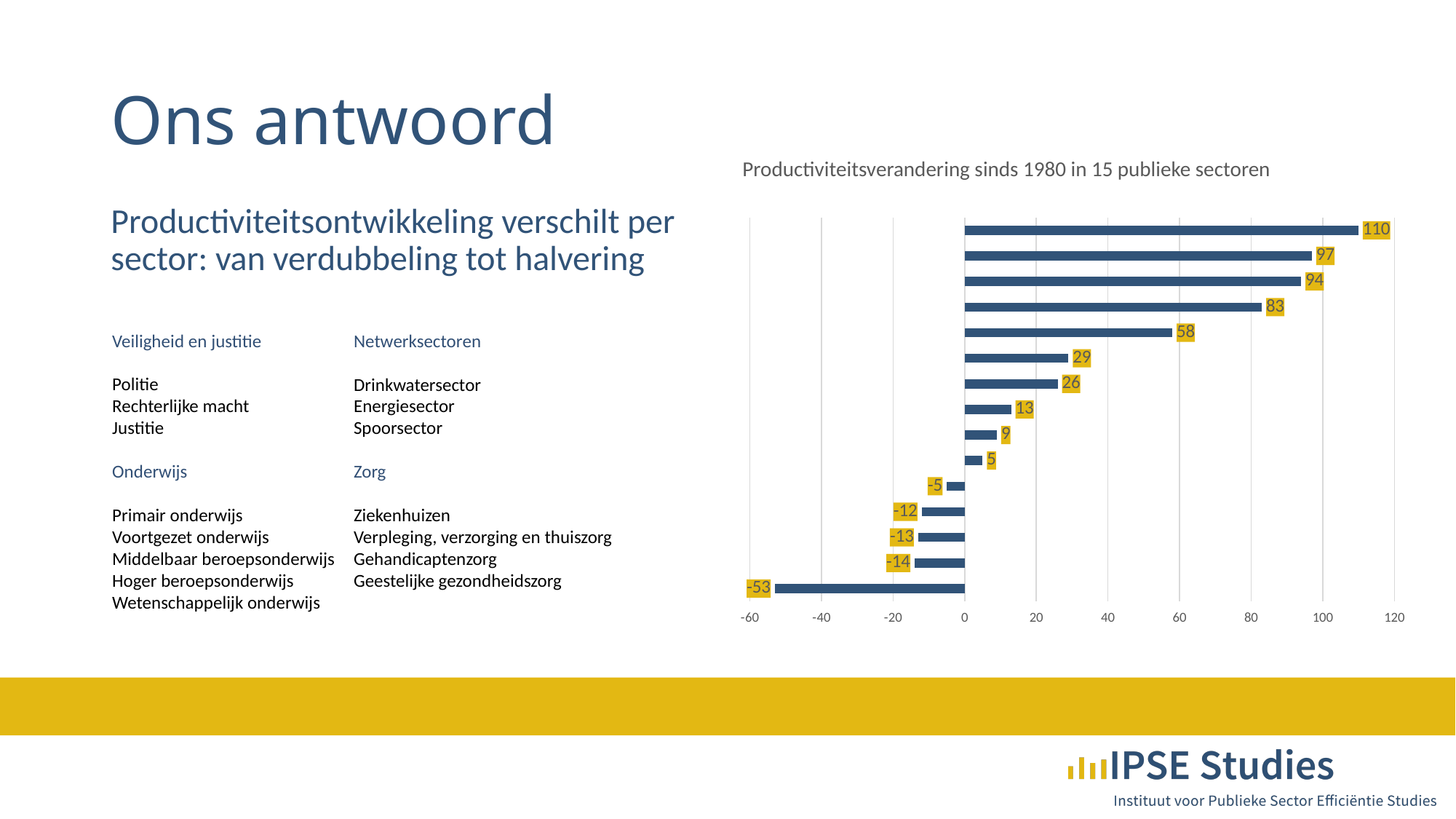
How many bars in the chart have a negative value? 5 What kind of chart is shown on the slide? bar chart What is the lowest value shown in the chart? -53 What is the smallest positive value shown in the chart? 5 Is the longest bar in the chart greater or less than 100? greater What is the title of the chart? Productiviteitsverandering sinds 1980 in 15 publieke sectoren How many bars in the chart have a value greater than 50? 5 How many bars are plotted in the chart? 15 What is the difference between the highest value (110) and the lowest value (-53) in the chart? 163 What is the difference between the two largest values in the chart, 110 and 97? 13 What is the highest value shown in the chart? 110 What is the value of the second-longest bar in the chart? 97